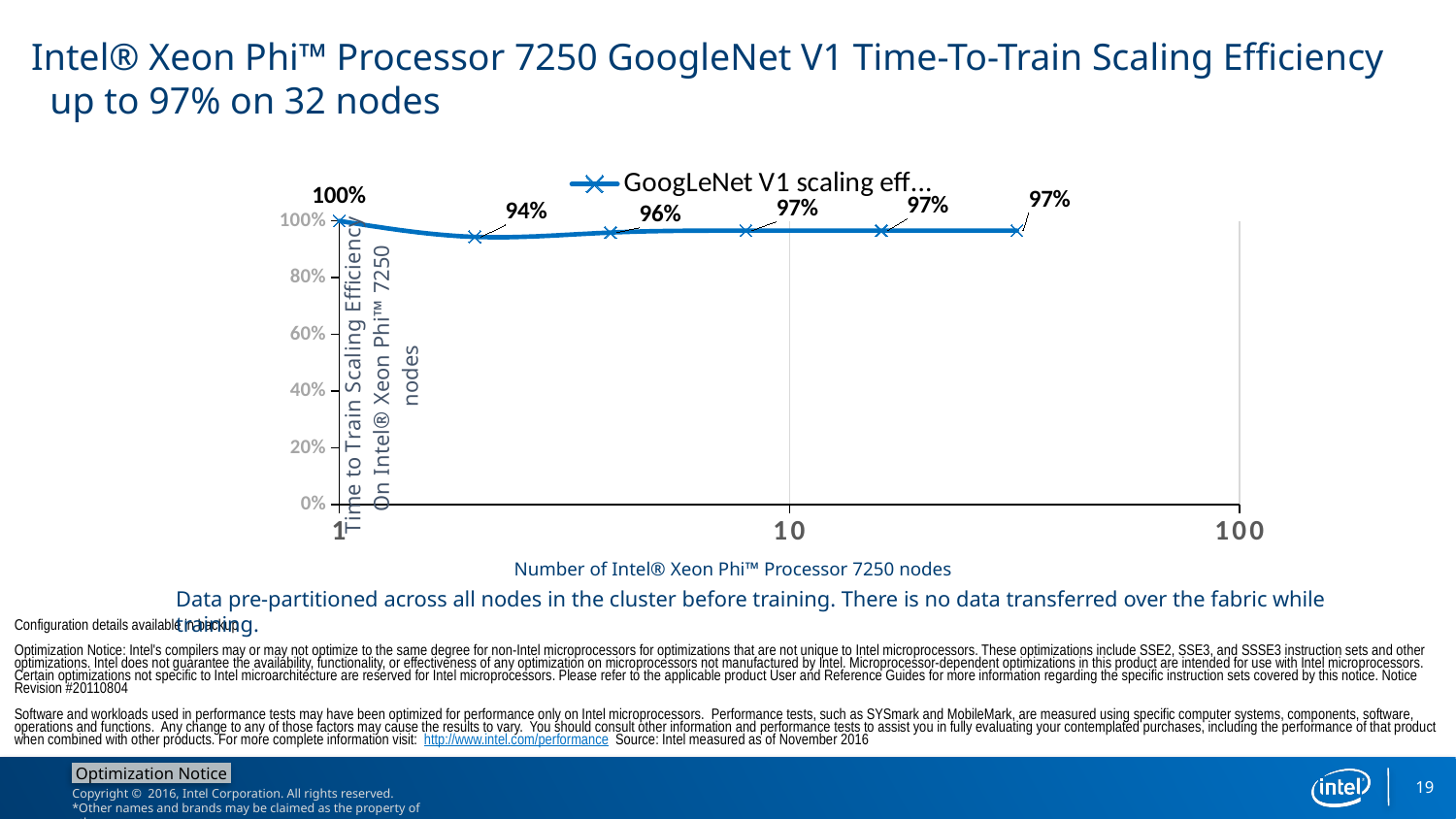
Is the lowest plotted value greater or less than 80%? greater What is the difference between the highest labeled value (100%) and the lowest labeled value (94%)? 6% What is the scaling efficiency value labeled at the first data point (1 node)? 100% What is the scaling efficiency value labeled at the rightmost data point? 97% What kind of chart is shown on the slide? line chart Which is larger, the second data point (94%) or the third data point (96%)? the third data point (96%) How many data points are plotted on the line? 6 What is the title of the x axis? Number of Intel® Xeon Phi™ Processor 7250 nodes How many series does the legend list? 1 After the dip to 94% at the second point, do the values rise or fall along the x axis? rise What is the lowest scaling efficiency value labeled on the chart? 94% What is the highest scaling efficiency value labeled on the chart? 100%